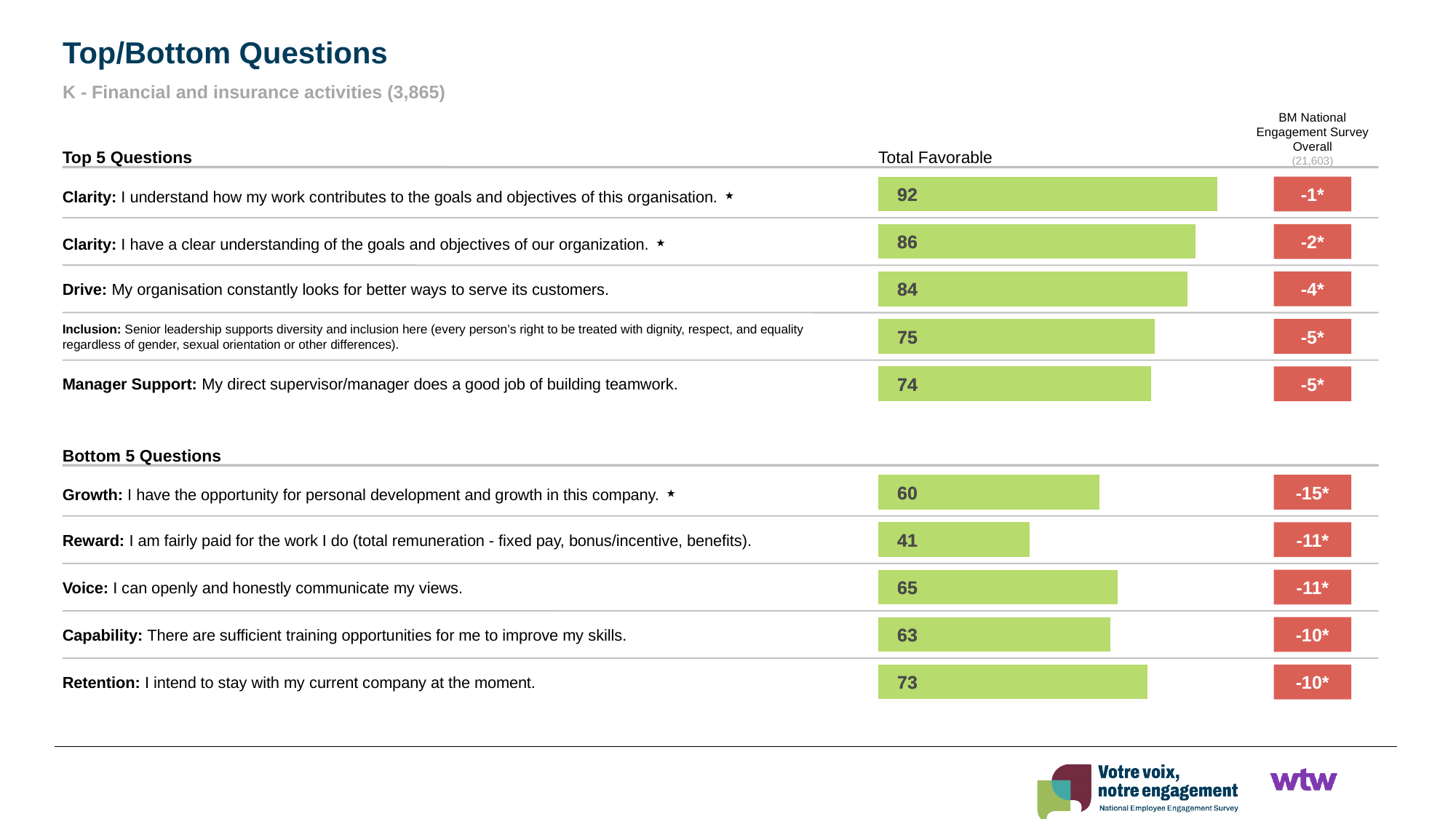
How many questions are shown in the Bottom 5 Questions chart? 5 In the Top 5 Questions chart, what is the difference in Total Favorable between the Drive question and the Inclusion question? 9 In the Top 5 Questions chart, what is the Total Favorable value for "Clarity: I understand how my work contributes to the goals and objectives of this organisation"? 92 What is the title of the slide containing these charts? Top/Bottom Questions In the Bottom 5 Questions chart, what is the BM National Engagement Survey Overall difference shown for the Growth question? -15* In the Bottom 5 Questions chart, which has a higher Total Favorable value: the Retention question or the Capability question? Retention In the Top 5 Questions chart, which question has the highest Total Favorable value? Clarity: I understand how my work contributes to the goals and objectives of this organisation In the Bottom 5 Questions chart, what is the difference in Total Favorable between the Voice question and the Reward question? 24 In the Top 5 Questions chart, what is the Total Favorable value for "Manager Support: My direct supervisor/manager does a good job of building teamwork"? 74 What kind of chart is used to show the Total Favorable values on this slide? Bar chart In the Bottom 5 Questions chart, which question has the lowest Total Favorable value? Reward: I am fairly paid for the work I do In the Bottom 5 Questions chart, what is the Total Favorable value for "Reward: I am fairly paid for the work I do"? 41